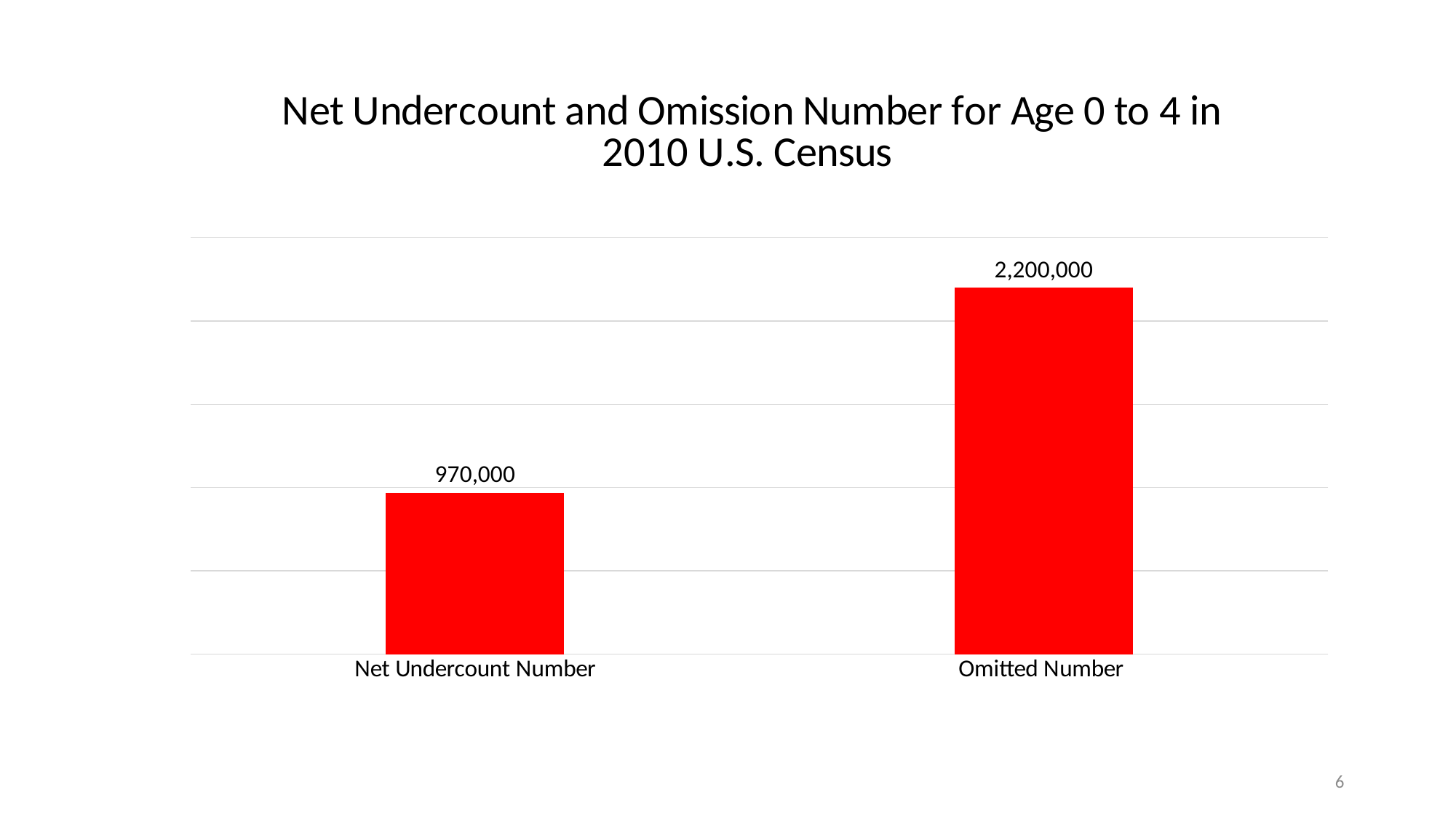
What kind of chart is shown on the slide? Bar chart Which category has the lowest value? Net Undercount Number How many categories are shown in the chart? 2 What is the value for Net Undercount Number? 970,000 Do the values rise or fall from left to right across the categories? Rise Which category has the highest value? Omitted Number What colour are the bars in the chart? Red What is the value for Omitted Number? 2,200,000 What is the title of the chart? Net Undercount and Omission Number for Age 0 to 4 in 2010 U.S. Census What is the difference between the Omitted Number and the Net Undercount Number? 1,230,000 Which is larger, the Net Undercount Number or the Omitted Number? Omitted Number